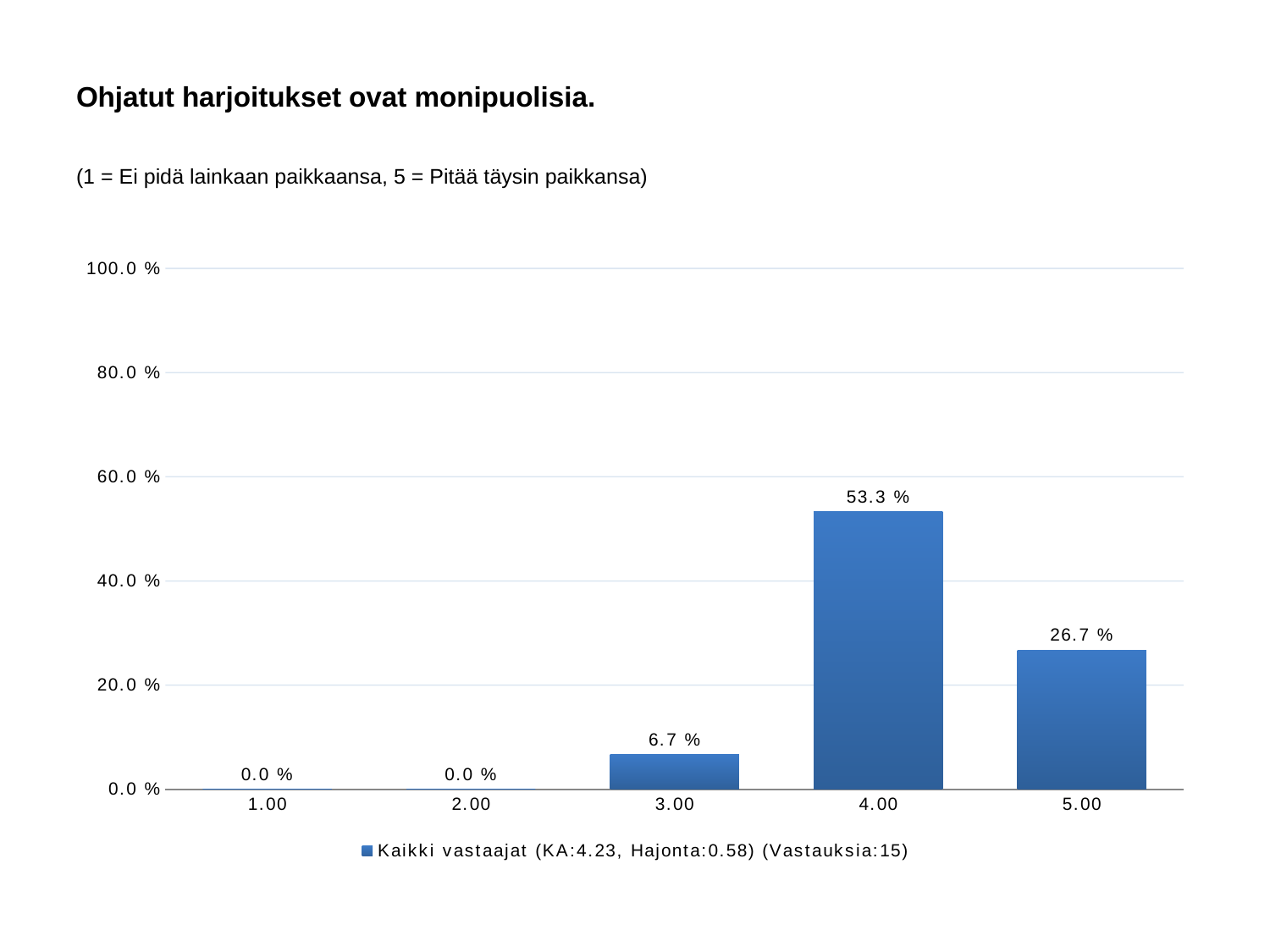
What is the value for category 4.00? 53.3 % What is the legend entry for the series shown? Kaikki vastaajat (KA:4.23, Hajonta:0.58) (Vastauksia:15) What is the value for category 5.00? 26.7 % What is the value for category 3.00? 6.7 % What kind of chart is shown on the slide? bar chart Which is larger, the value for 3.00 or the value for 5.00? 5.00 What is the difference between the values for 5.00 and 3.00? 20.0 % Is the value for 4.00 greater or less than 40.0 %? greater What is the value for category 1.00? 0.0 % How many categories are shown on the x axis? 5 Which category has the highest value? 4.00 What is the difference between the values for 4.00 and 5.00? 26.6 %